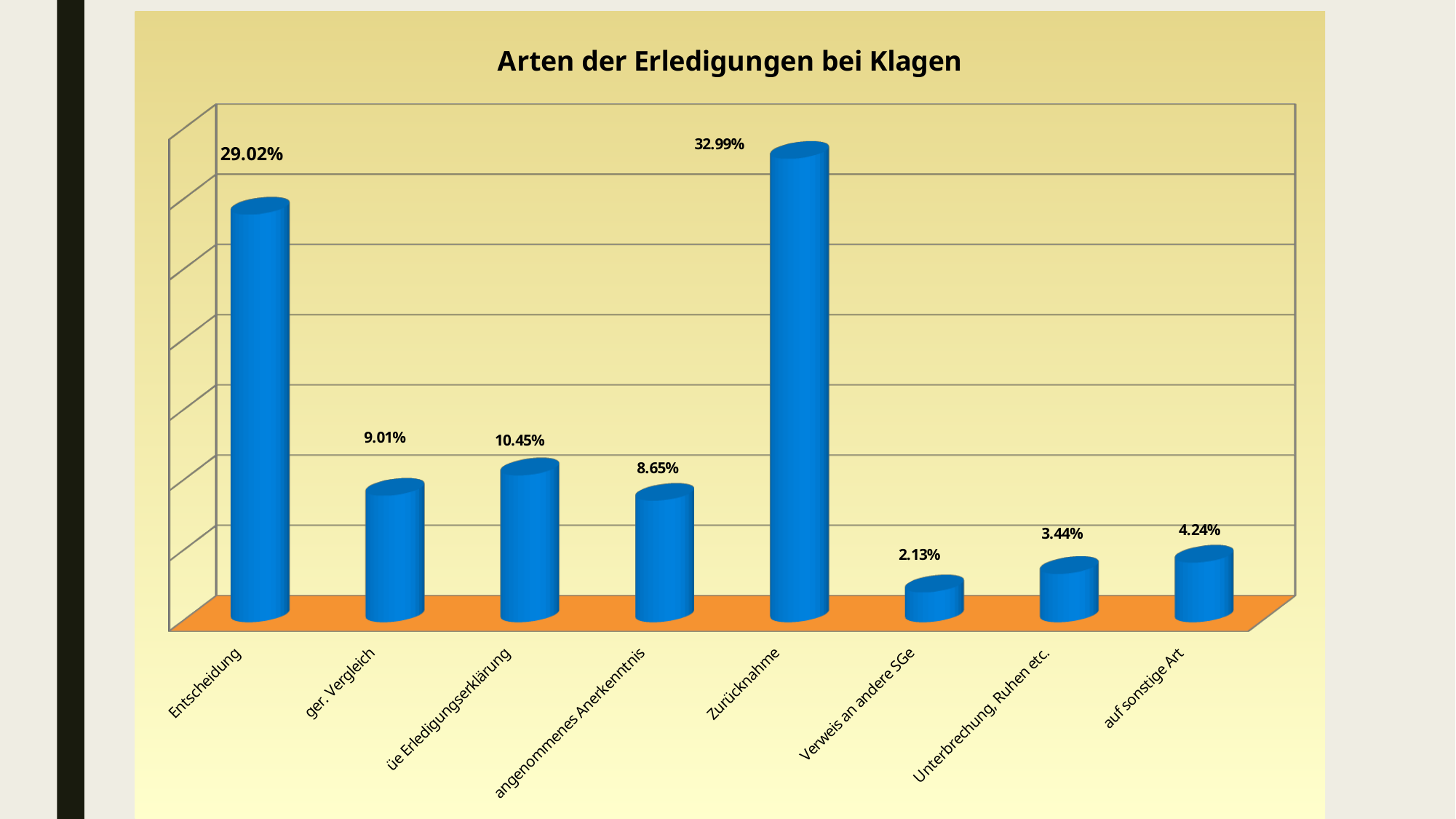
What is the value for auf sonstige Art? 4.24% What is the value for Entscheidung? 29.02% What kind of chart is this? bar chart What is the difference between the values for Zurücknahme and Entscheidung? 3.97% What is the value for Verweis an andere SGe? 2.13% What is the value for Zurücknahme? 32.99% Which is larger, the value for angenommenes Anerkenntnis or the value for ger. Vergleich? ger. Vergleich Which category has the highest value? Zurücknahme Which category has the lowest value? Verweis an andere SGe What is the title of the chart? Arten der Erledigungen bei Klagen What is the difference between the values for üe Erledigungserklärung and ger. Vergleich? 1.44% How many categories are shown on the x axis? 8